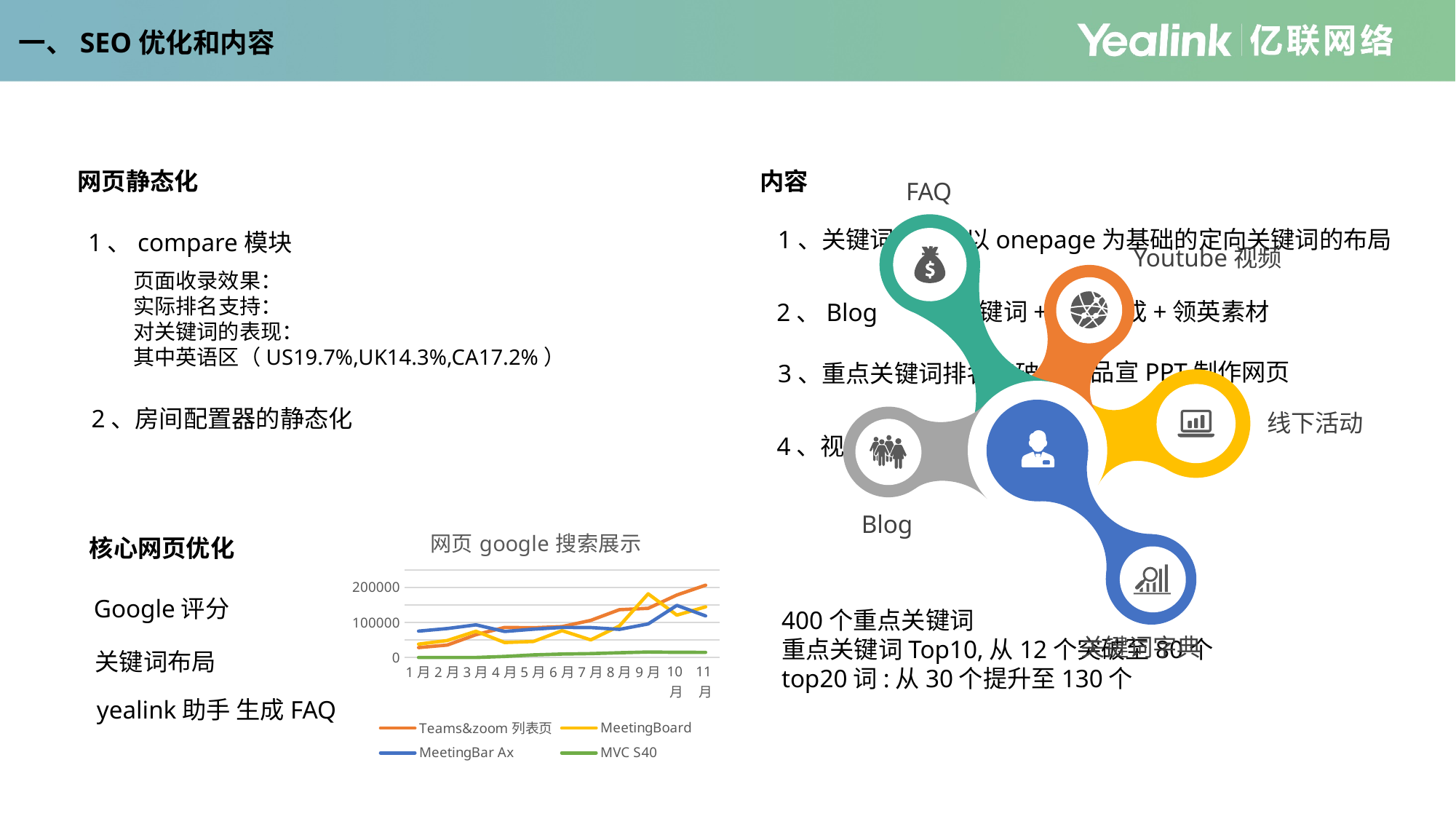
Which colour is used for the MVC S40 series in the chart? green Is the value for MeetingBar Ax at 1月 greater or less than 100000? less How many series does the chart's legend list? 4 Does the Teams&zoom 列表页 series generally rise or fall from 1月 to 11月? rise What is the title of the chart on the slide? 网页 google 搜索展示 At 9月, which is larger: MeetingBoard or Teams&zoom 列表页? MeetingBoard Is the value for Teams&zoom 列表页 at 11月 greater or less than 100000? greater How many months are plotted along the x axis of the chart? 11 What kind of chart is shown on the slide? line chart Is the value for MVC S40 at 11月 greater or less than 100000? less Which series has the highest value at 11月? Teams&zoom 列表页 Which series has the lowest values across the whole chart? MVC S40